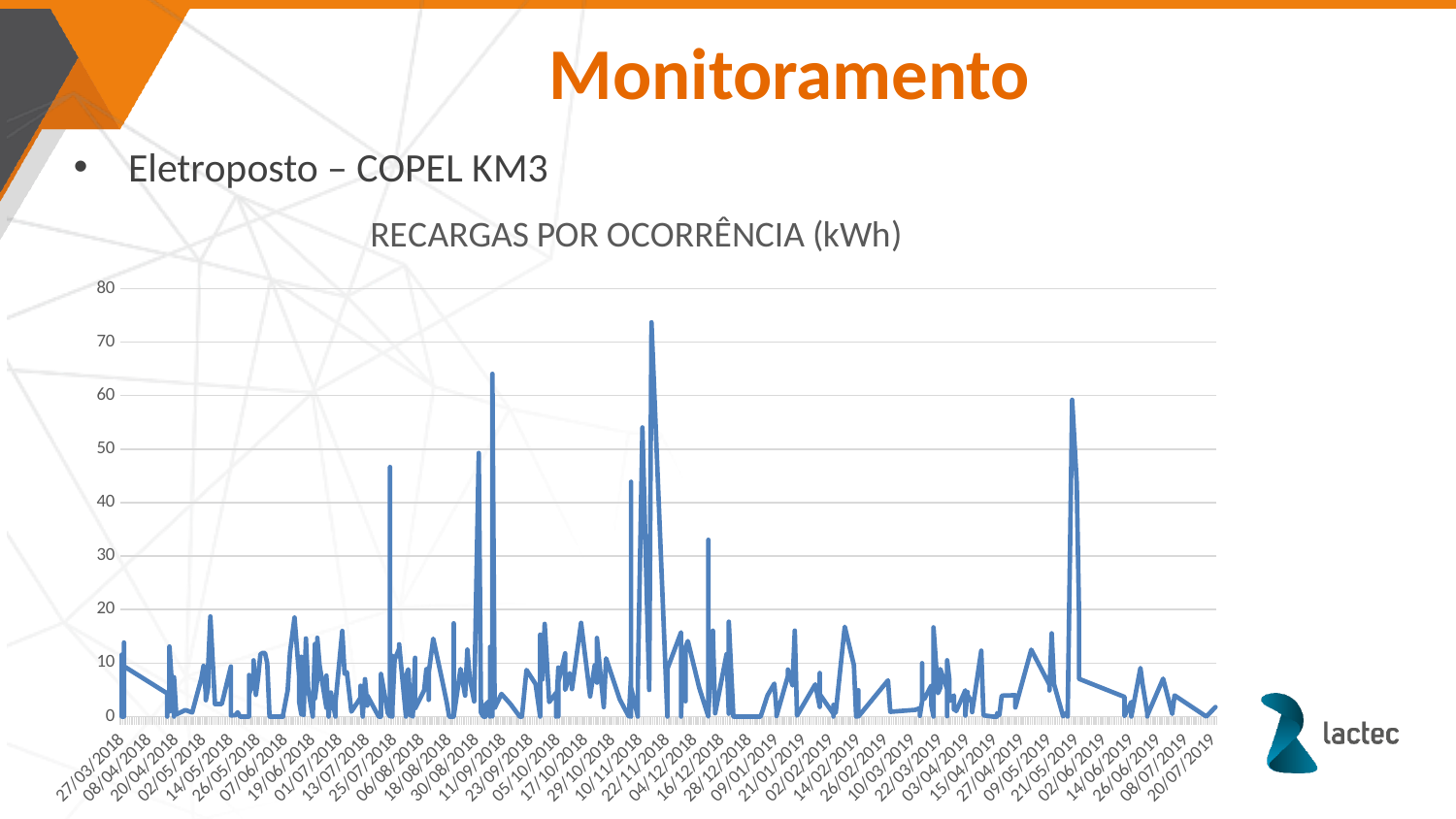
What is the highest value shown on the vertical axis? 80 Which is larger: the peak near 22/11/2018 or the peak near 16/12/2018? the peak near 22/11/2018 Is the peak near 06/08/2018 greater or less than 40? greater What kind of chart is shown on the slide? line chart Is the highest peak of the line greater or less than 70? greater Is the peak near 02/06/2019 greater or less than 50? greater What unit is indicated in the chart title? kWh What is the title of the chart? RECARGAS POR OCORRÊNCIA (kWh) What is the first date label on the horizontal axis? 27/03/2018 What is the last date label on the horizontal axis? 20/07/2019